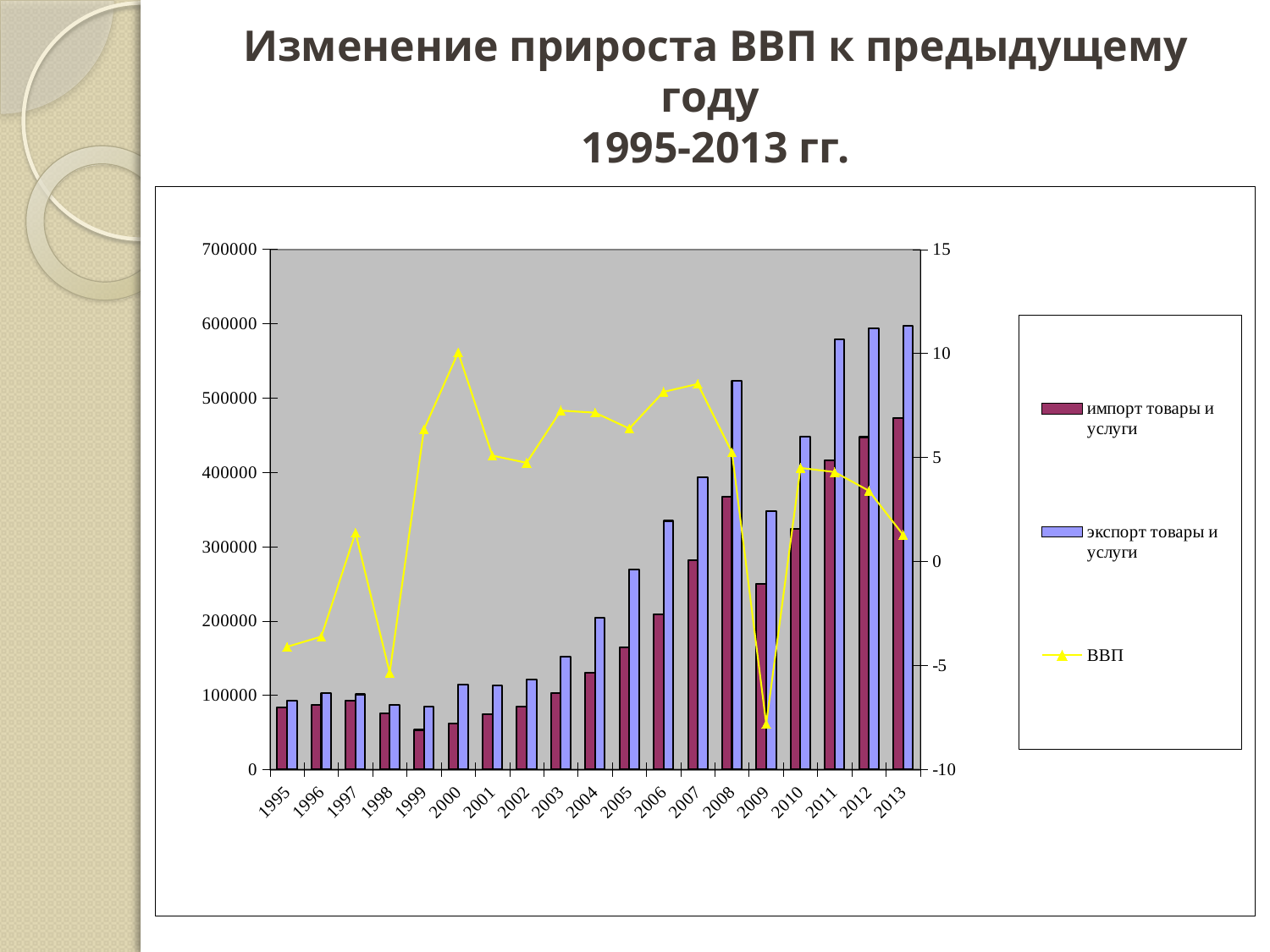
In which year is the bar for импорт товары и услуги the highest? 2013 In which year does the ВВП line reach its highest point? 2000 What colour is the ВВП line in the chart? Yellow Is the ВВП value for 2009 greater or less than -5? less In 2011, which is larger: импорт товары и услуги or экспорт товары и услуги? экспорт товары и услуги How many years are shown on the x axis of the chart? 19 How many series does the chart legend list? 3 In which year does the ВВП line reach its lowest point? 2009 Is the value for импорт товары и услуги in 2009 greater or less than 300000? less In which year is the bar for импорт товары и услуги the lowest? 1999 Is the value for экспорт товары и услуги in 2013 greater or less than 500000? greater What kind of chart is shown on the slide? A combined bar and line chart